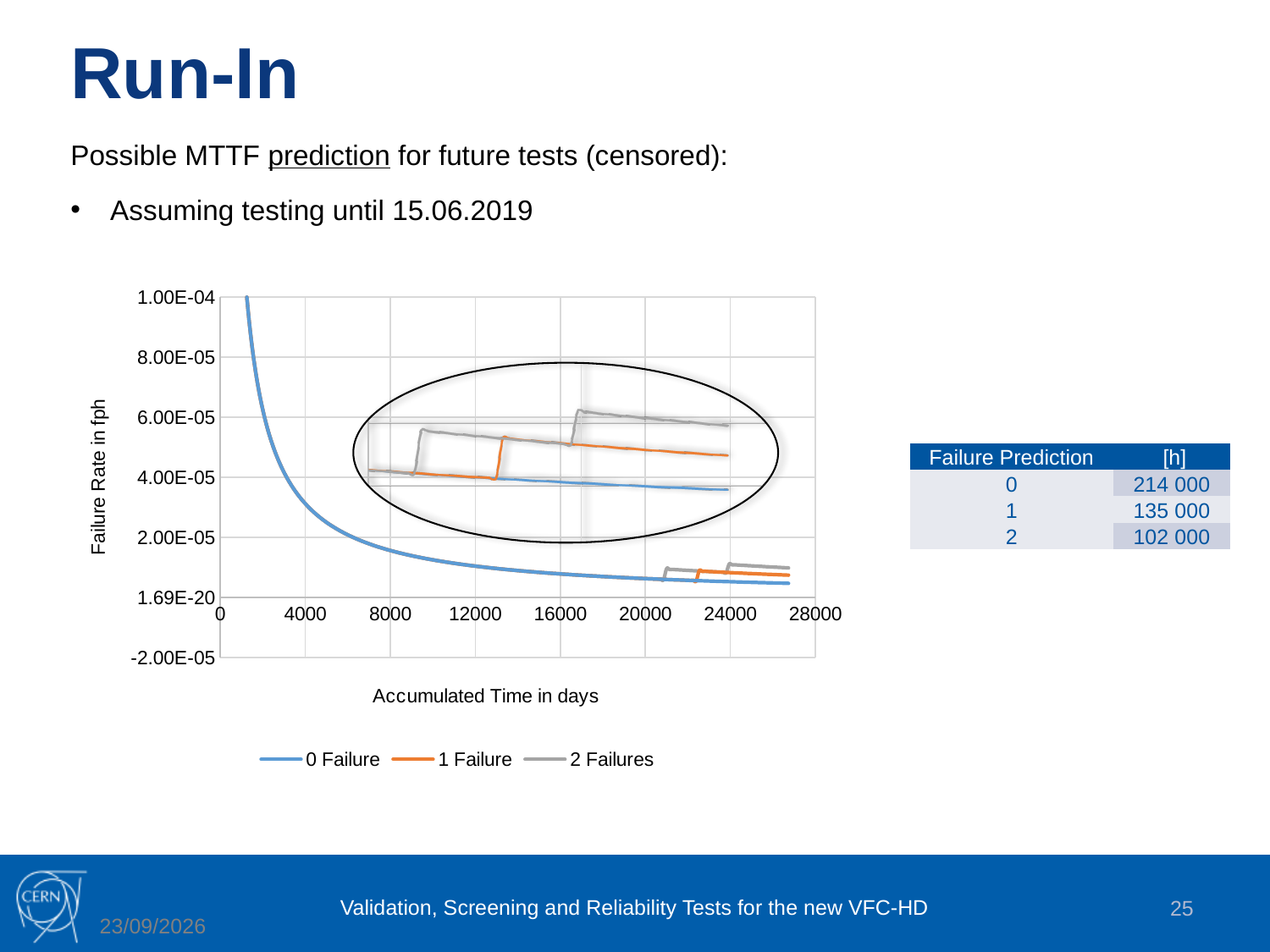
What kind of chart is shown on the slide? line chart What is the title of the chart's x axis? Accumulated Time in days Does the 0 Failure series rise or fall as accumulated time increases? fall At the right end of the chart (around 24000 days), which series has the lowest failure rate? 0 Failure Is the 0 Failure value at 12000 days greater or less than 2.00E-05? less Is the 2 Failures value at 24000 days greater or less than 2.00E-05? less Is the 0 Failure value at 4000 days greater or less than 6.00E-05? less At the right end of the chart (around 24000 days), which series has the highest failure rate? 2 Failures How many series does the chart legend list? 3 At around 24000 days, which series has the larger failure rate, 1 Failure or 0 Failure? 1 Failure What are the series names listed in the chart legend? 0 Failure, 1 Failure, 2 Failures